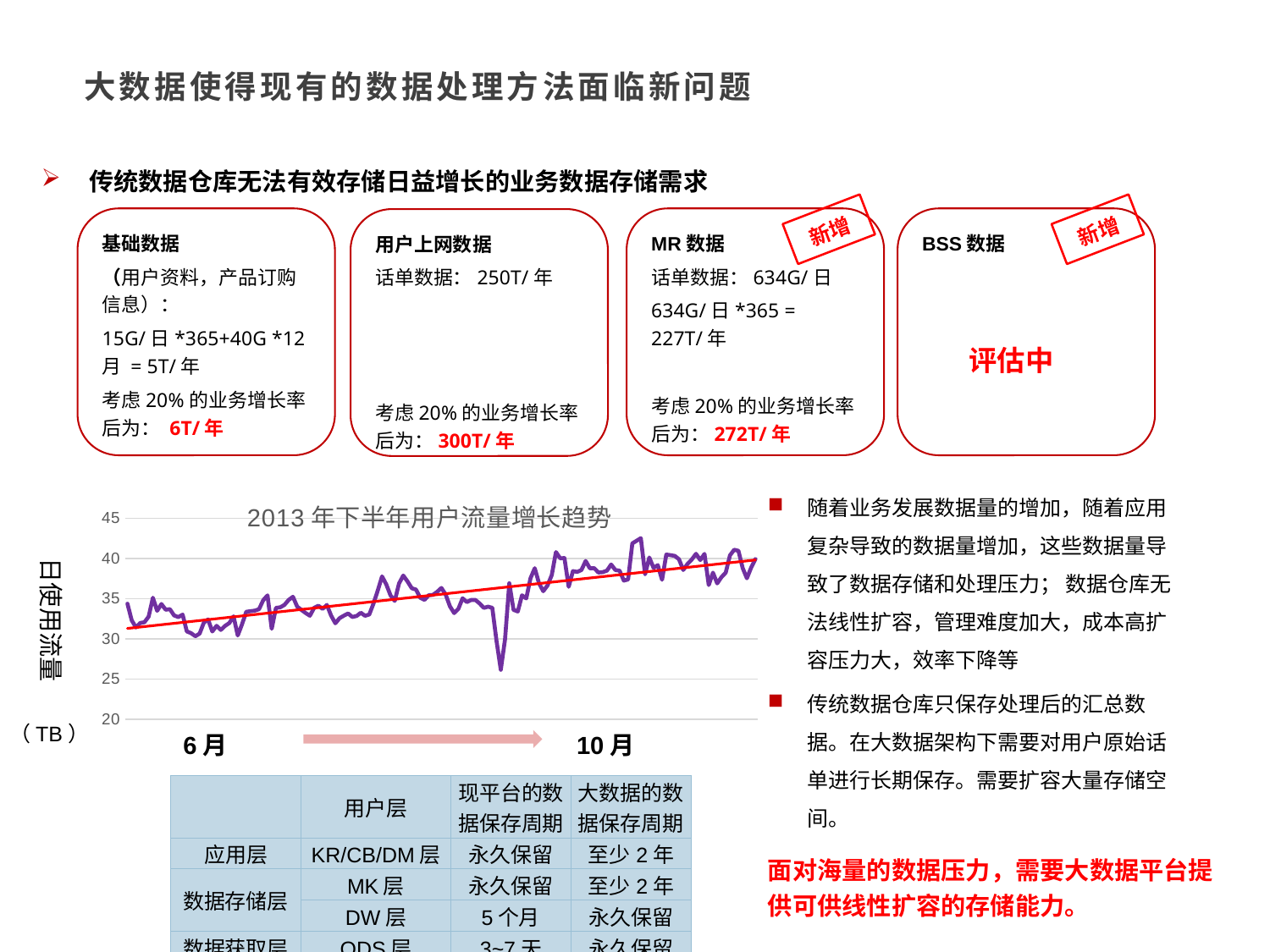
Is the highest point of the purple line greater or less than 40? greater What kind of chart is shown on the slide? line chart What is the highest tick value shown on the y axis of the chart? 45 What is the lowest tick value shown on the y axis of the chart? 20 Is the lowest point of the purple line greater or less than 30? less Do the values in the chart generally rise or fall from 6月 to 10月? rise Is the value at the start of the line (6月) greater or less than 30? greater Which month label appears at the left end of the x axis? 6月 What is the title of the chart? 2013年下半年用户流量增长趋势 What unit is shown for the y axis of the chart? TB Which month label appears at the right end of the x axis? 10月